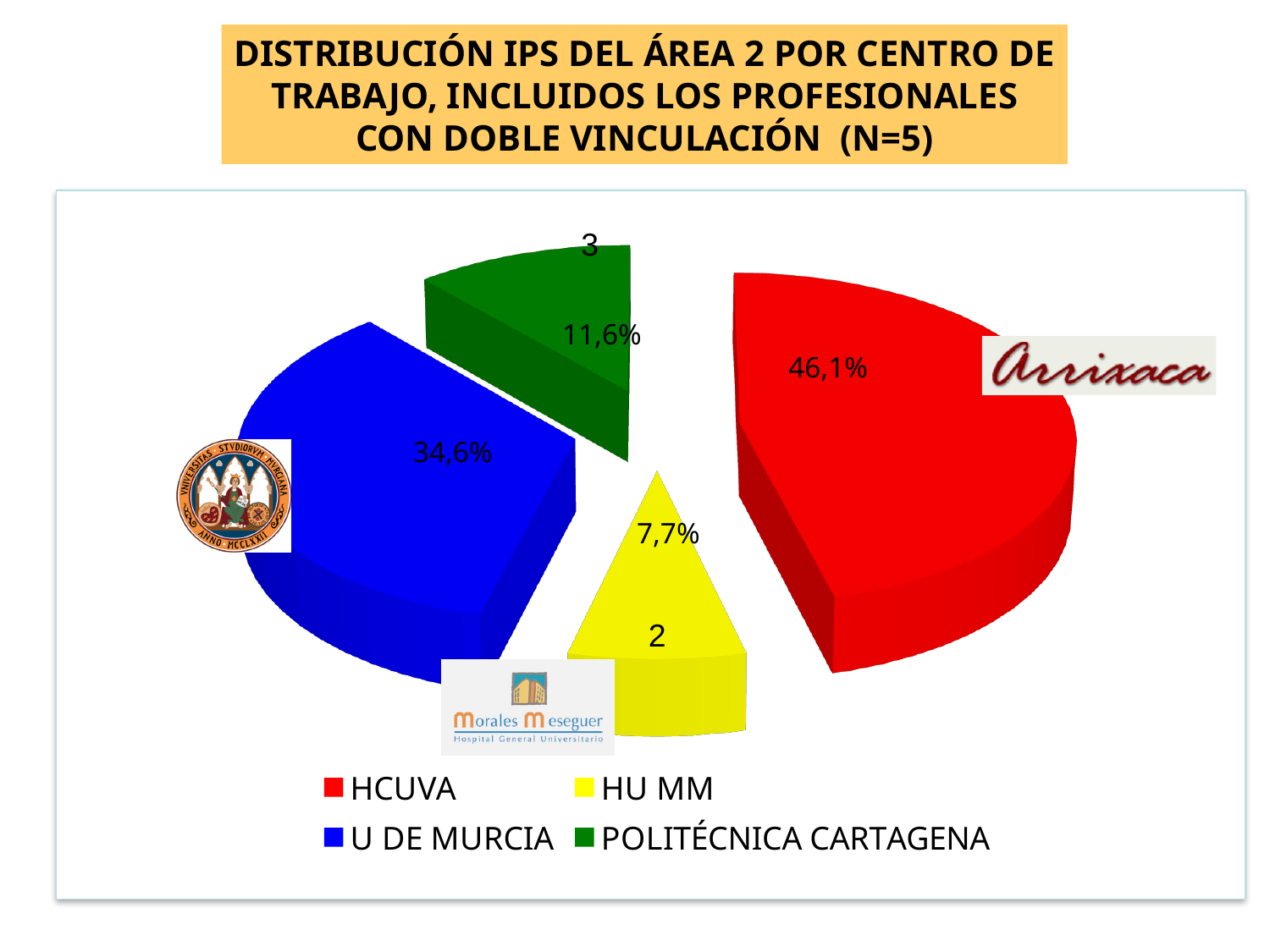
Which has a larger share, U DE MURCIA or POLITÉCNICA CARTAGENA? U DE MURCIA What is the difference in percentage points between the HCUVA share and the U DE MURCIA share? 11,5 What percentage share does U DE MURCIA have in the pie chart? 34,6% How many entries does the legend list? 4 What percentage share does HU MM have in the pie chart? 7,7% What kind of chart is shown on the slide? Pie chart What colour is the slice for POLITÉCNICA CARTAGENA? Green What percentage share does POLITÉCNICA CARTAGENA have in the pie chart? 11,6% What percentage share does HCUVA have in the pie chart? 46,1% Which category has the largest slice of the pie chart? HCUVA How many slices does the pie chart have? 4 Which category has the smallest slice of the pie chart? HU MM